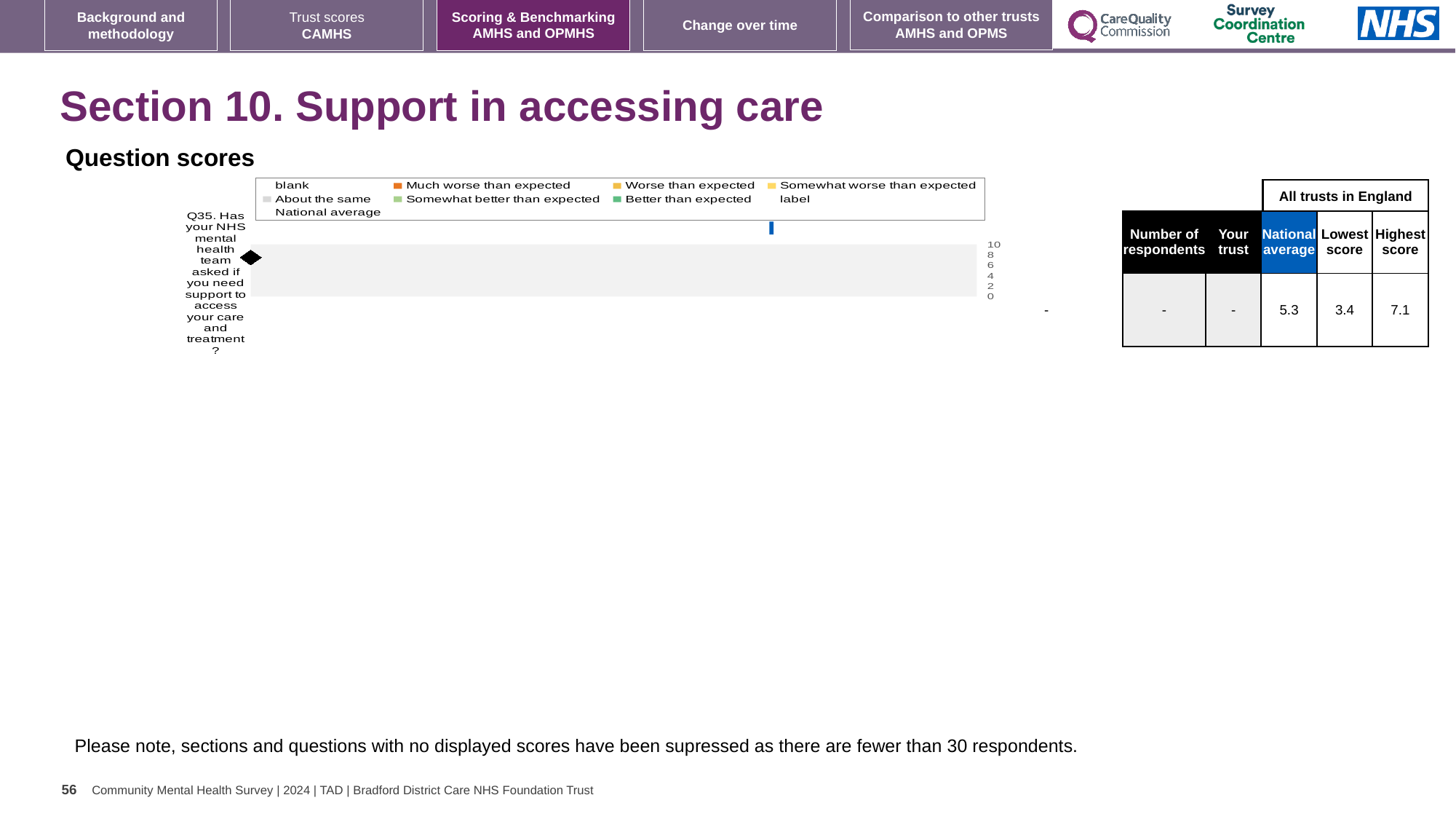
In the chart legend, what colour represents "Much worse than expected"? orange In the table next to the chart, what is the Lowest score among all trusts in England for Q35? 3.4 In the table next to the chart, what is the Highest score among all trusts in England for Q35? 7.1 How many questions (categories) are plotted on the "Question scores" chart? 1 What kind of chart is shown under the heading "Question scores"? bar chart In the table next to the chart, what is the difference between the Highest score and the Lowest score for Q35? 3.7 In the table next to the chart, what is shown in the "Your trust" column for Q35? - In the table next to the chart, is the National average for Q35 greater or less than the Lowest score? greater What is the highest tick value shown on the axis of the "Question scores" chart? 10 In the table next to the chart, what is the National average score for Q35? 5.3